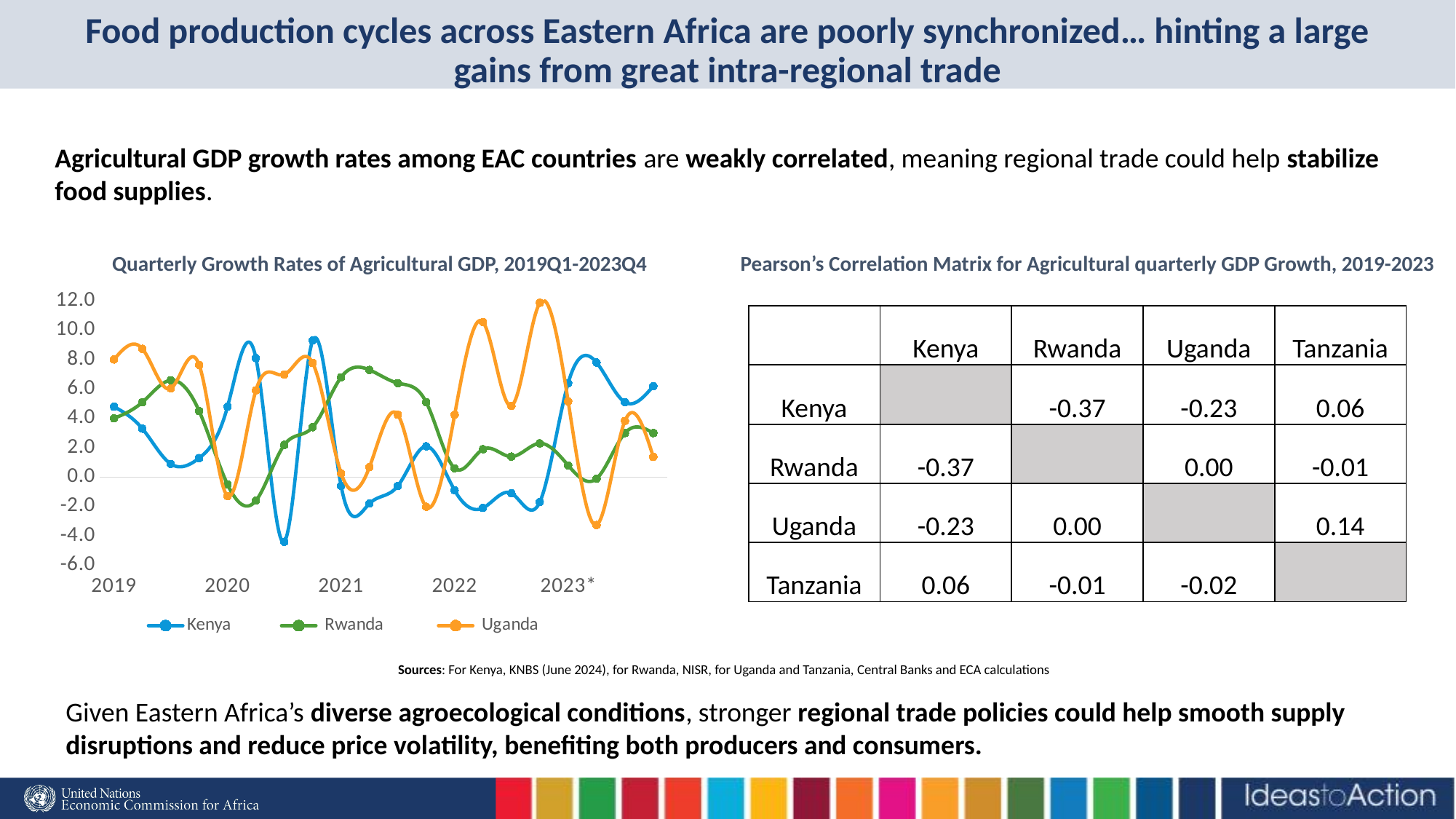
Is the highest value reached by Rwanda greater or less than 6.0? greater Is the lowest value reached by Uganda greater or less than -2.0? less What kind of chart is shown on the slide? line chart Which country's line reaches the highest value on the chart? Uganda Is the highest value reached by Kenya greater or less than 8.0? greater Which country's line reaches the lowest value on the chart? Kenya Which colour is used for the Uganda line in the chart? orange What is the highest value shown on the y axis of the line chart? 12.0 How many series does the legend of the line chart list? 3 What is the title of the line chart? Quarterly Growth Rates of Agricultural GDP, 2019Q1-2023Q4